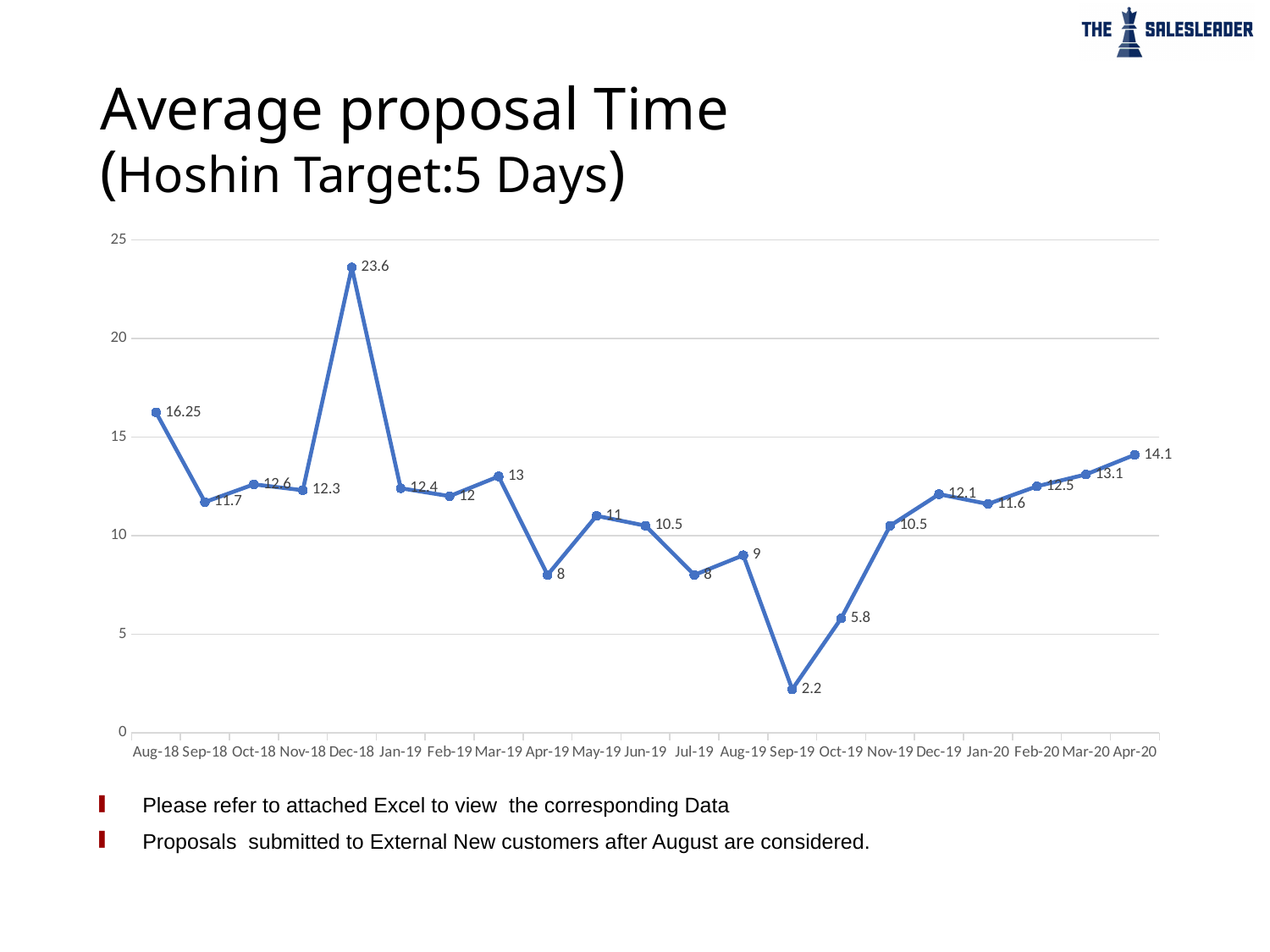
What is the value for Sep-19? 2.2 What is the value for Dec-18? 23.6 Which month has the highest value? Dec-18 What is the value for Apr-20? 14.1 Do the values rise or fall from Sep-19 to Apr-20? Rise What is the difference between the values for Dec-18 and Jan-19? 11.2 What kind of chart is shown on the slide? Line chart How many months are plotted on the chart? 21 Which month has the lowest value? Sep-19 What is the value for Aug-18? 16.25 Which is larger, the value for Mar-19 or the value for Apr-19? Mar-19 Is the value for Oct-19 greater or less than 10? less